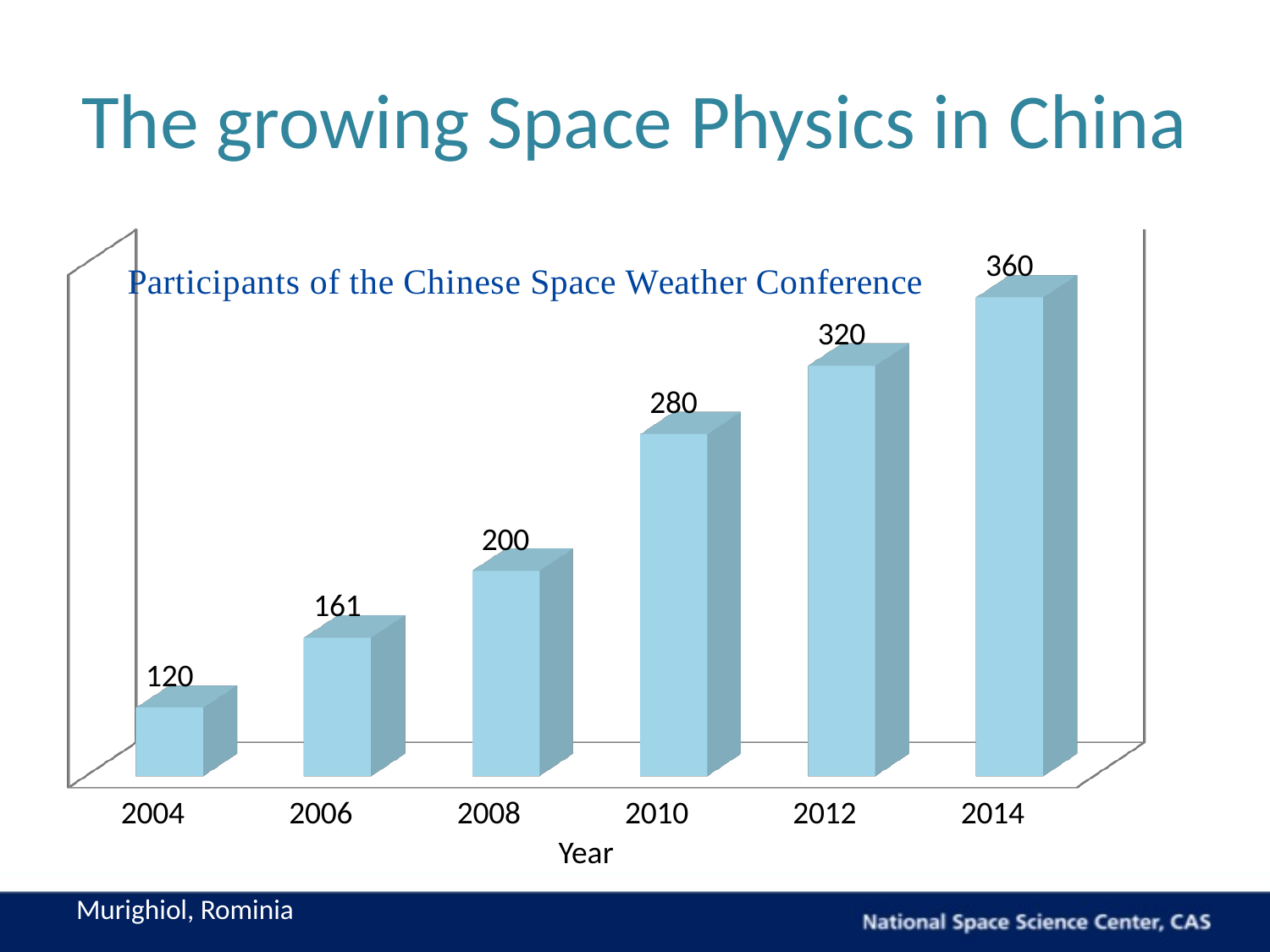
What is the value shown for 2008? 200 Which is larger, the value for 2010 or the value for 2008? 2010 How many participants attended the Chinese Space Weather Conference in 2004? 120 What is the label of the x axis? Year How many years are shown on the x axis? 6 What kind of chart is shown on the slide? bar chart Which year has the highest number of participants? 2014 Do the values rise or fall from 2004 to 2014? rise What is the difference between the values for 2006 and 2004? 41 What is the difference between the values for 2014 and 2004? 240 Which year has the lowest number of participants? 2004 What is the value shown for 2012? 320